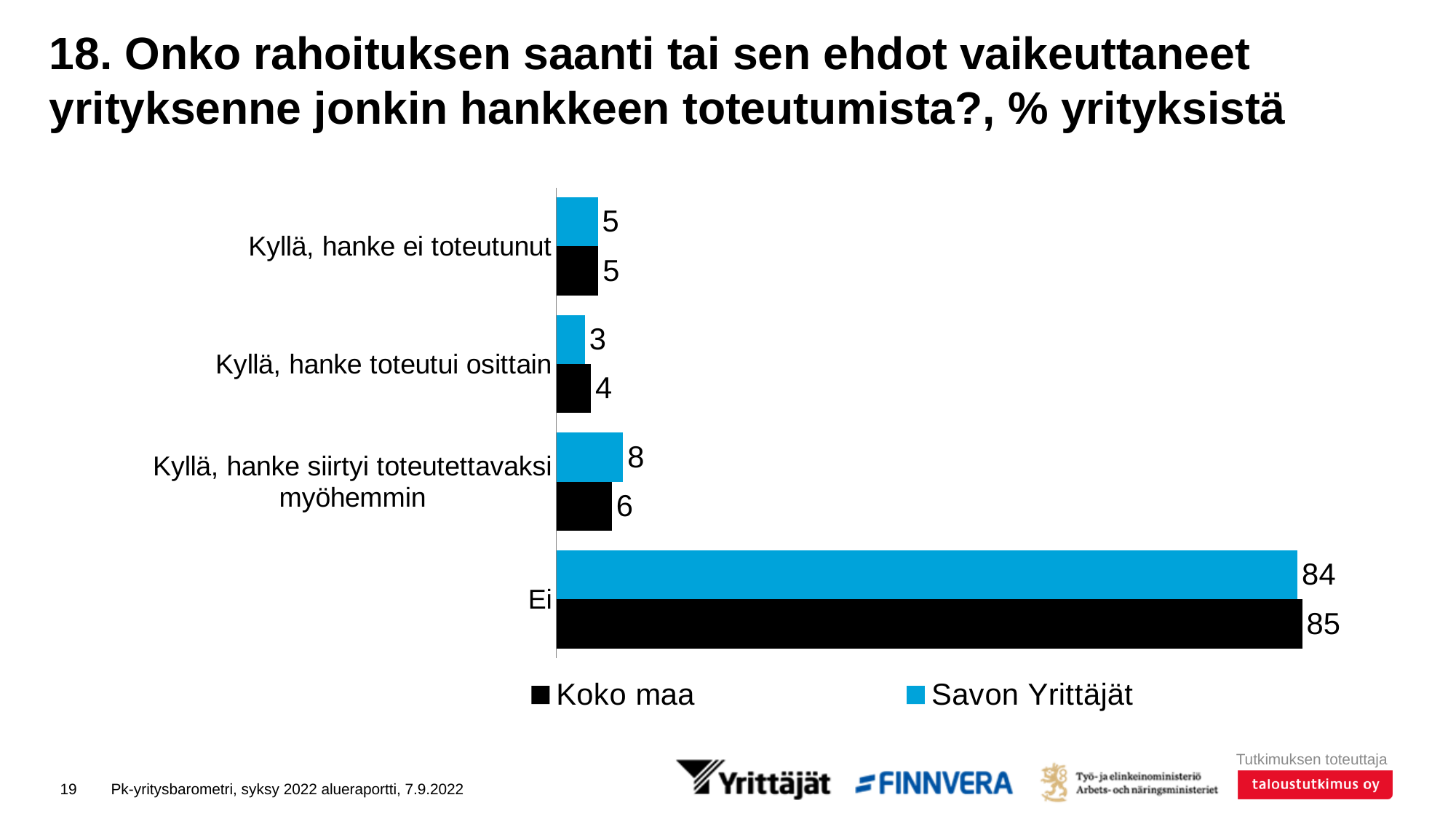
How many series does the legend list? 2 What is the value for Koko maa in the category "Ei"? 85 What is the difference between the Savon Yrittäjät and Koko maa values in the category "Kyllä, hanke siirtyi toteutettavaksi myöhemmin"? 2 What is the value for Savon Yrittäjät in the category "Ei"? 84 How many categories are shown on the chart? 4 In the category "Kyllä, hanke toteutui osittain", which series has the larger value, Koko maa or Savon Yrittäjät? Koko maa What kind of chart is shown on the slide? Bar chart Which colour represents the Savon Yrittäjät series? Blue What is the value for Savon Yrittäjät in the category "Kyllä, hanke siirtyi toteutettavaksi myöhemmin"? 8 What is the value for Koko maa in the category "Kyllä, hanke toteutui osittain"? 4 Which category has the lowest value for Savon Yrittäjät? Kyllä, hanke toteutui osittain Which category has the highest value for Koko maa? Ei